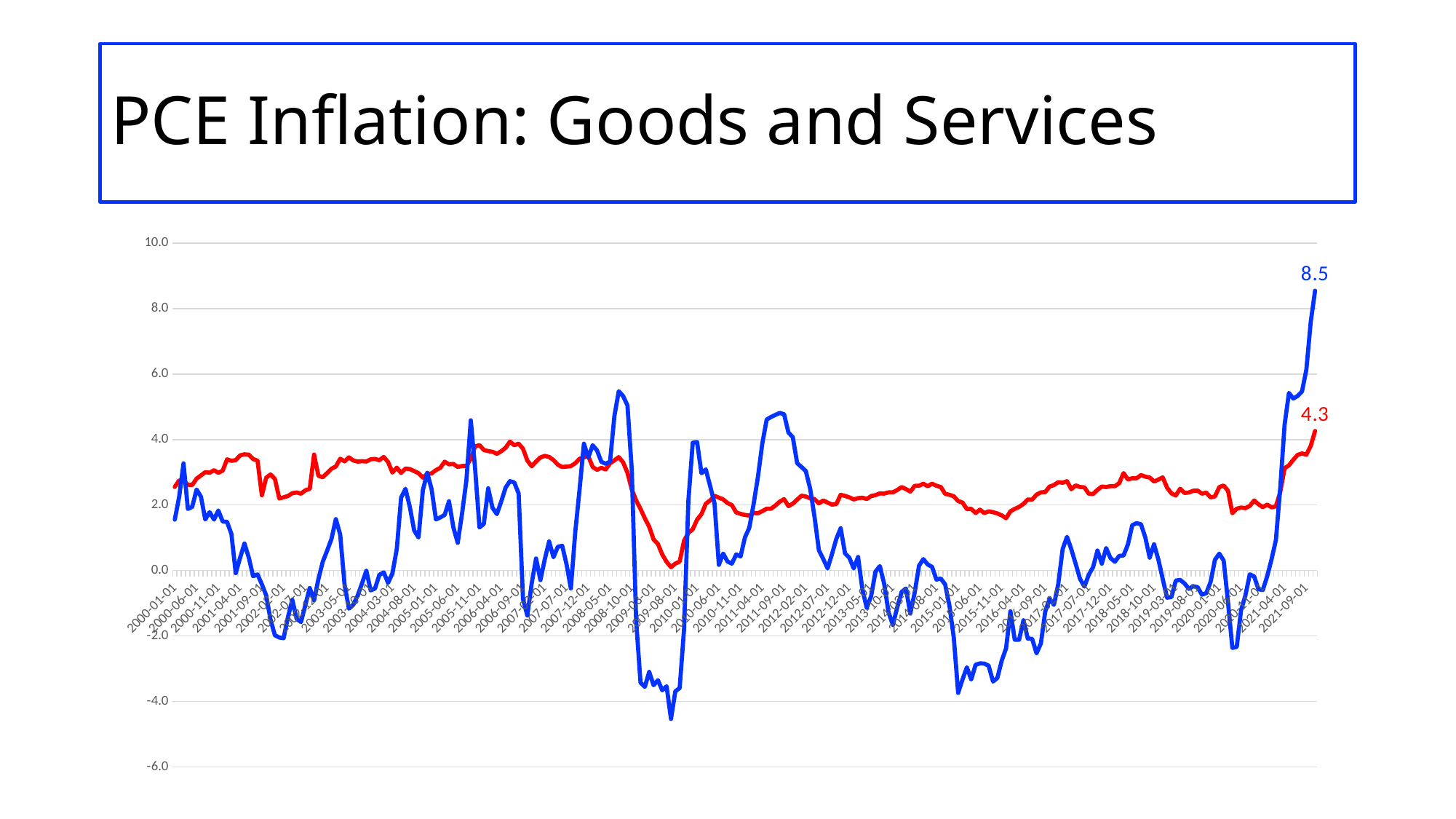
Which line reaches the highest value anywhere on the chart, the blue line or the red line? blue line What is the labelled final value of the blue line? 8.5 What is the labelled final value of the red line? 4.3 Is the peak of the blue line around 2008-10-01 greater or less than 5.0? greater Does the blue line rise or fall over the final stretch of the chart in 2021? rise Which line reaches the lowest value anywhere on the chart, the blue line or the red line? blue line What is the difference between the labelled final values of the blue line and the red line? 4.2 How many lines are plotted on the chart? 2 What is the title of the chart on the slide? PCE Inflation: Goods and Services What kind of chart is shown on the slide? line chart Is the lowest point of the blue line (around 2009) greater or less than -4.0? less At the right end of the chart, which line has the larger value, the blue line or the red line? blue line